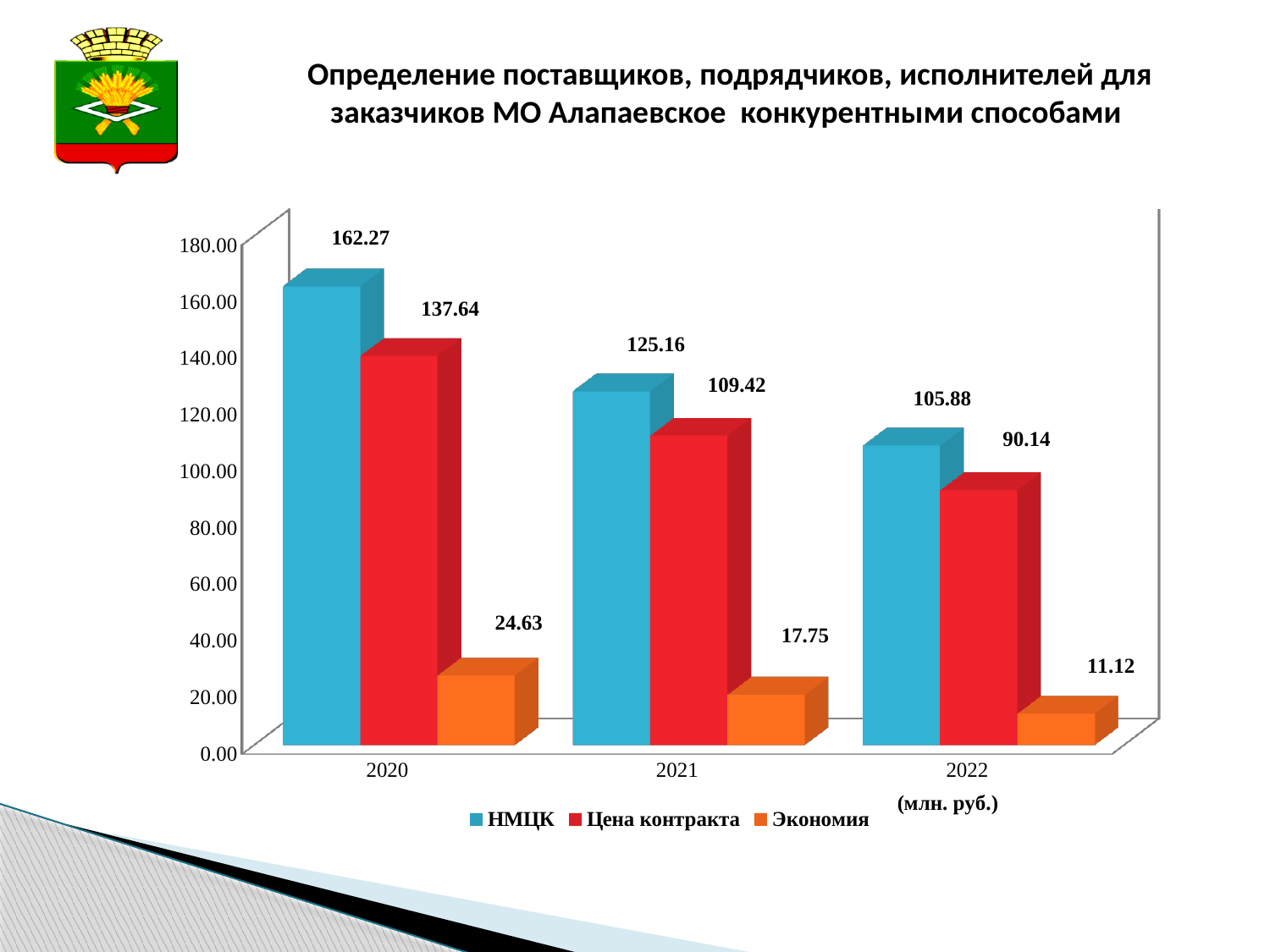
Does the value of НМЦК rise or fall from 2020 to 2022? fall What is the value of НМЦК for 2020? 162.27 Which is larger: Цена контракта in 2020 or НМЦК in 2021? Цена контракта in 2020 In which year is Экономия the lowest? 2022 In which year is НМЦК the highest? 2020 How many series does the legend list? 3 What is the value of Экономия for 2022? 11.12 What is the value of Цена контракта for 2021? 109.42 How many years are shown on the x axis? 3 Is the value of Цена контракта for 2022 greater or less than 100.00? less What is the difference between НМЦК and Цена контракта in 2022? 15.74 What kind of chart is shown on the slide? bar chart